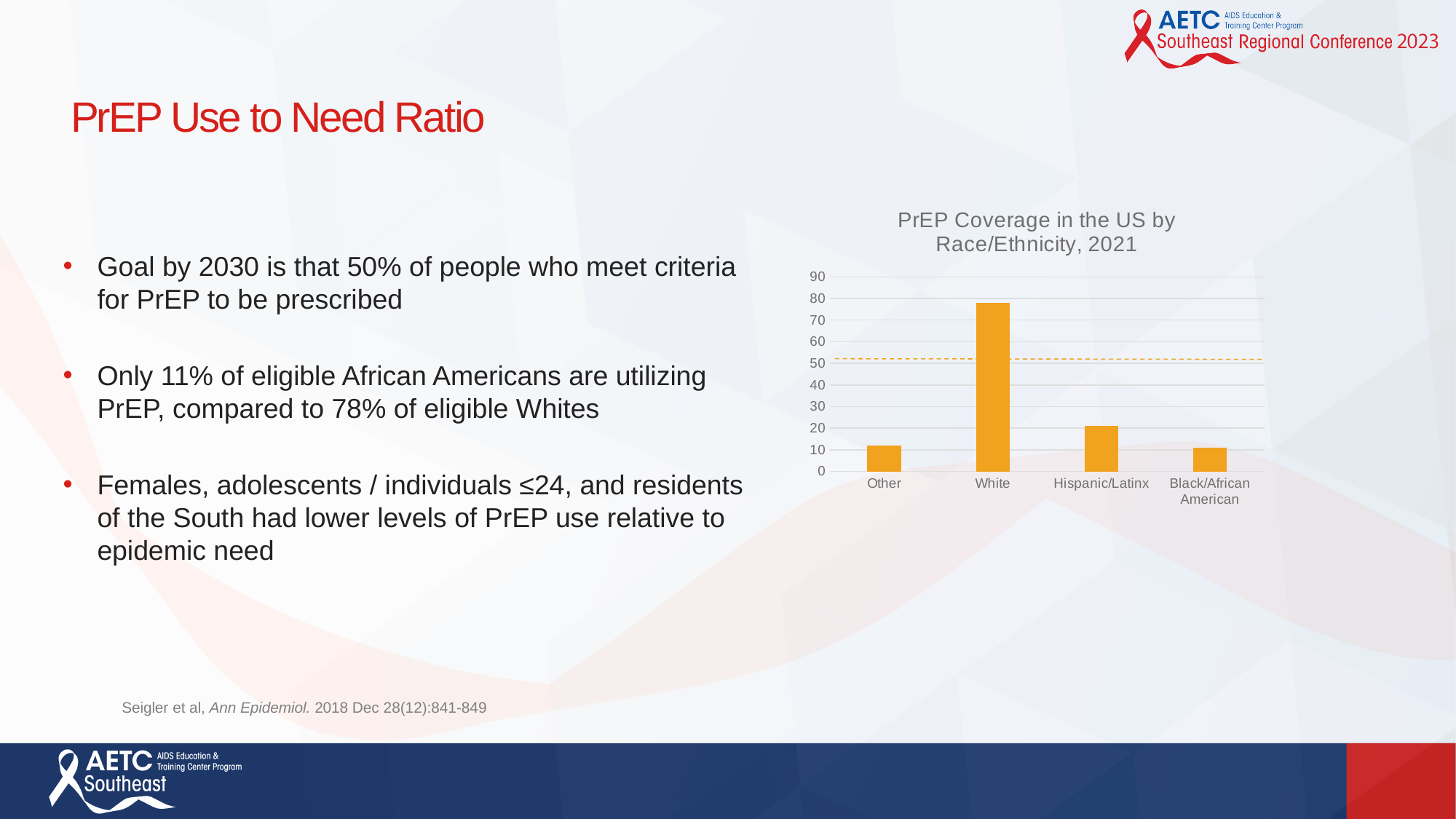
Is the value for Other greater or less than 20? less How many race/ethnicity categories are plotted in the chart? 4 Which is larger, the value for White or the value for Other? White Which category has the highest PrEP coverage in the chart? White What colour are the bars in the chart? orange Is the value for White greater or less than 70? greater Is the value for Black/African American greater or less than 20? less What is the title of the chart? PrEP Coverage in the US by Race/Ethnicity, 2021 What type of chart is shown on the slide? bar chart Which is larger, the value for Hispanic/Latinx or the value for Black/African American? Hispanic/Latinx